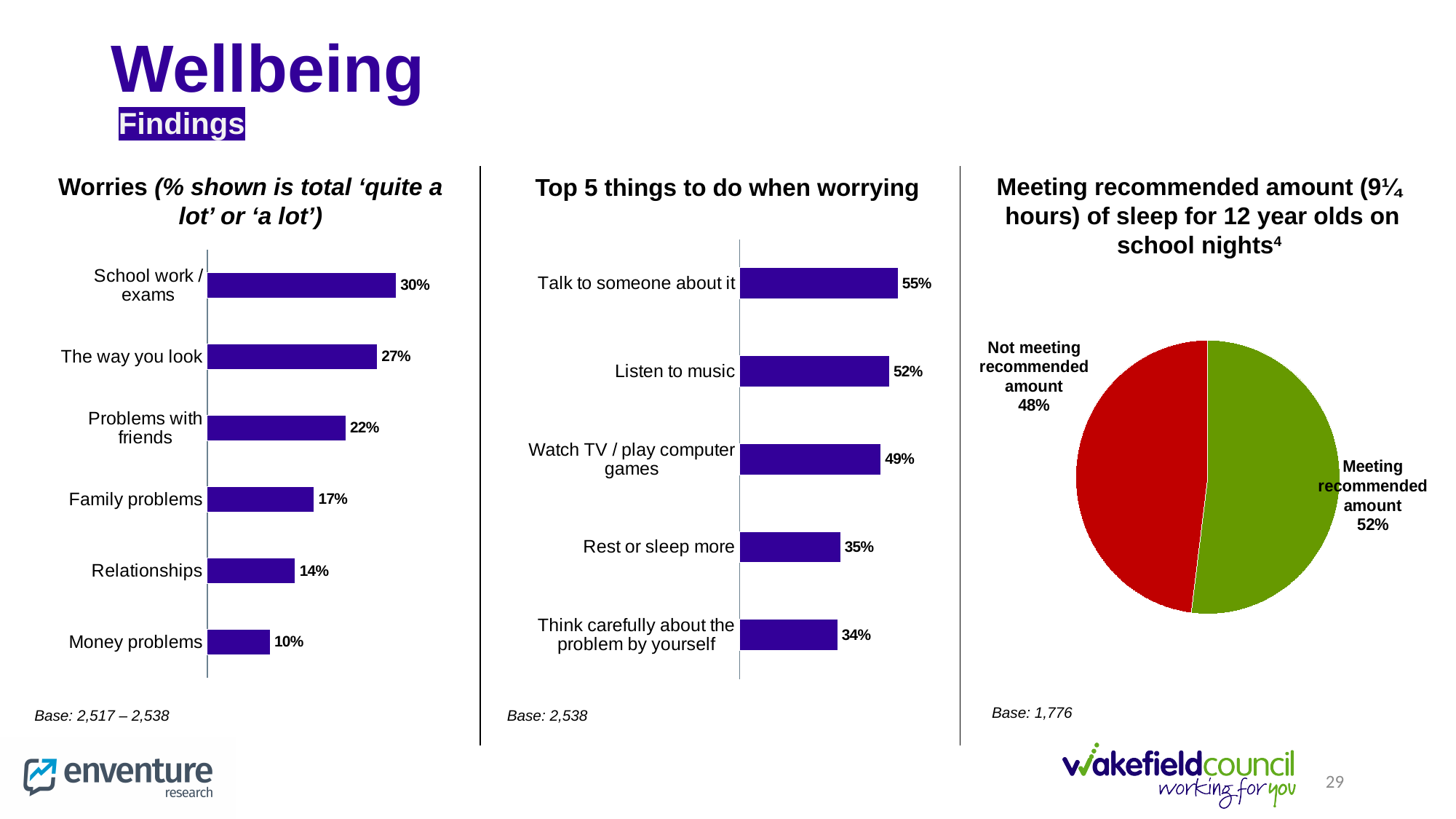
In the pie chart on the right, what colour is the 'Not meeting recommended amount' slice? Red In the 'Top 5 things to do when worrying' chart, what is the difference between 'Talk to someone about it' and 'Think carefully about the problem by yourself'? 21% In the 'Worries' chart, how many categories are plotted? 6 In the 'Worries' chart, what is the difference between 'The way you look' and 'Family problems'? 10% In the 'Worries' chart, which category has the lowest value? Money problems In the pie chart on the right, what share is 'Meeting recommended amount'? 52% In the 'Top 5 things to do when worrying' chart, which category has the highest value? Talk to someone about it What kind of chart is the 'Top 5 things to do when worrying' chart? Bar chart In the 'Top 5 things to do when worrying' chart, what percentage is shown for 'Listen to music'? 52% In the 'Top 5 things to do when worrying' chart, which is larger: 'Rest or sleep more' or 'Watch TV / play computer games'? Watch TV / play computer games In the 'Worries' chart, what percentage is shown for 'School work / exams'? 30% In the pie chart on the right, which slice is larger: 'Meeting recommended amount' or 'Not meeting recommended amount'? Meeting recommended amount